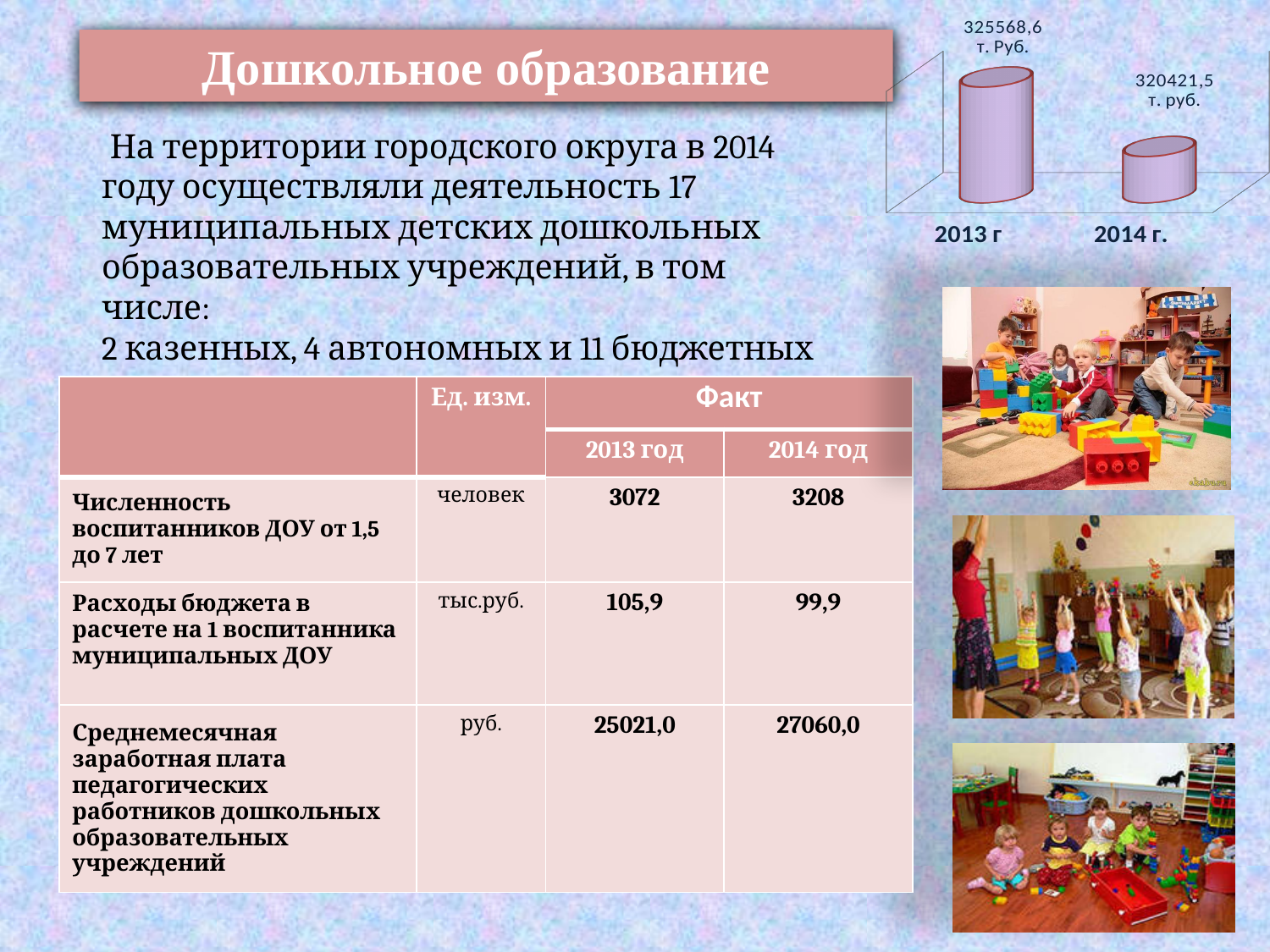
Do the values rise or fall from 2013 г to 2014 г. in the chart? fall What value is shown for 2013 г in the chart? 325568,6 т. Руб. By how much does the 2013 г value exceed the 2014 г. value in the chart? 5147,1 Which year has the higher value in the chart? 2013 г How many categories (years) are plotted in the chart? 2 Is the value for 2013 г larger or smaller than the value for 2014 г.? larger What value is shown for 2014 г. in the chart? 320421,5 т. руб. What kind of chart is shown in the top right of the slide? bar chart Which year has the lower value in the chart? 2014 г. In what units are the values in the chart expressed? т. руб.